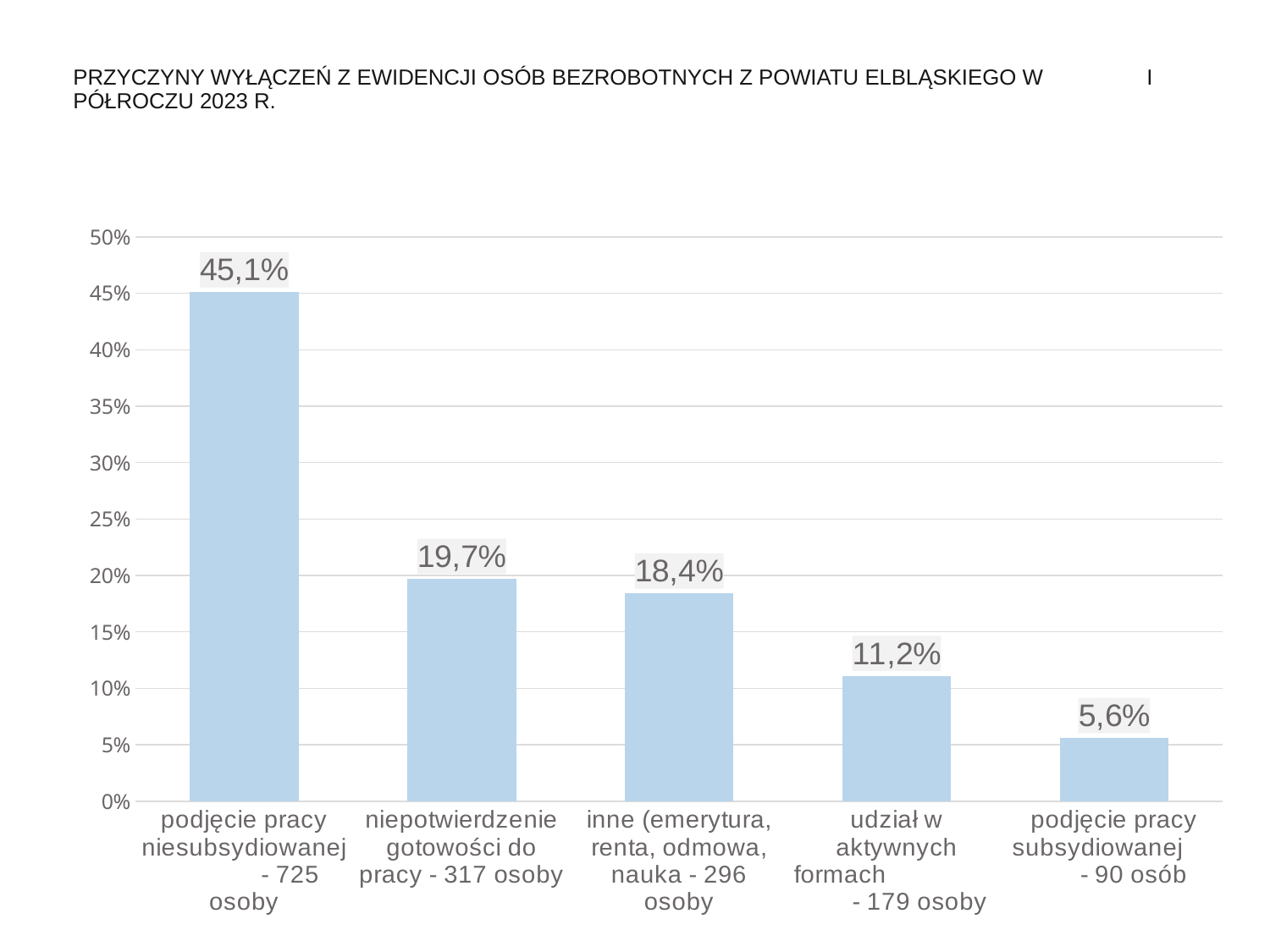
What is the value for "niepotwierdzenie gotowości do pracy - 317 osoby"? 19,7% What is the difference in percentage points between "podjęcie pracy niesubsydiowanej" (45,1%) and "niepotwierdzenie gotowości do pracy" (19,7%)? 25,4 percentage points What is the value for "podjęcie pracy subsydiowanej - 90 osób"? 5,6% Do the values rise or fall from left to right across the categories? fall Which is larger: the value for "niepotwierdzenie gotowości do pracy" or the value for "inne (emerytura, renta, odmowa, nauka)"? niepotwierdzenie gotowości do pracy How many categories are shown in the chart? 5 What kind of chart is shown on the slide? bar chart What percentage is shown for "udział w aktywnych formach - 179 osoby"? 11,2% Which category has the highest value? podjęcie pracy niesubsydiowanej - 725 osoby Is the value for "inne (emerytura, renta, odmowa, nauka - 296 osoby)" greater or less than 20%? less What percentage is shown for "podjęcie pracy niesubsydiowanej - 725 osoby"? 45,1% Which category has the lowest value? podjęcie pracy subsydiowanej - 90 osób